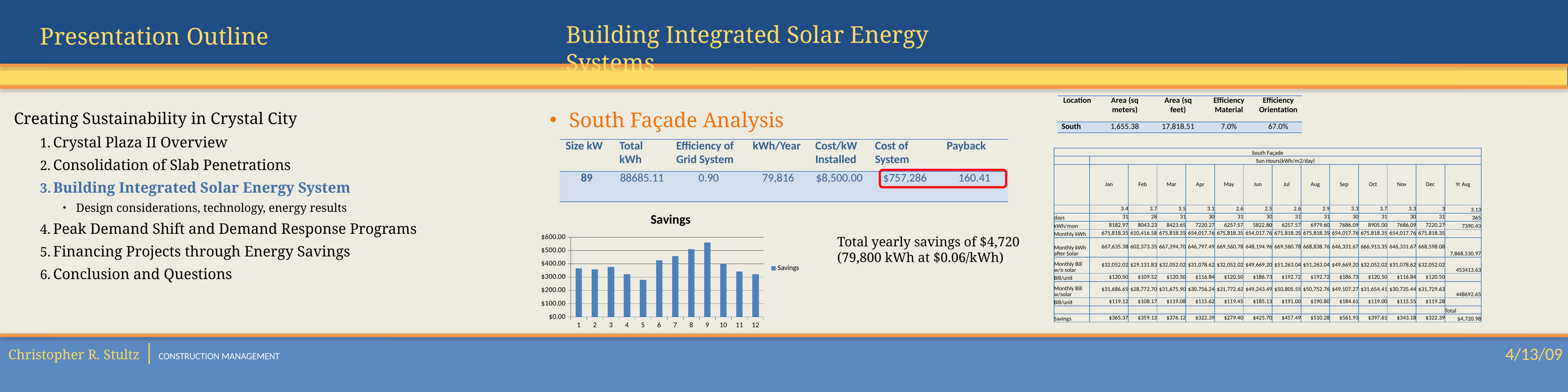
How many bars are plotted in the Savings chart? 12 How many series does the legend of the Savings chart list? 1 In the Savings chart, is the value for category 7 greater or less than $400.00? greater Which category has the lowest bar in the Savings chart? 5 Which category has the highest bar in the Savings chart? 9 In the Savings chart, is the value for category 9 greater or less than $500.00? greater What is the title of the bar chart on the slide? Savings In the Savings chart, is the value for category 12 greater or less than $400.00? less In the Savings chart, which is larger, the value for category 2 or the value for category 7? 7 What type of chart is the Savings chart? bar chart In the Savings chart, which is larger, the value for category 8 or the value for category 10? 8